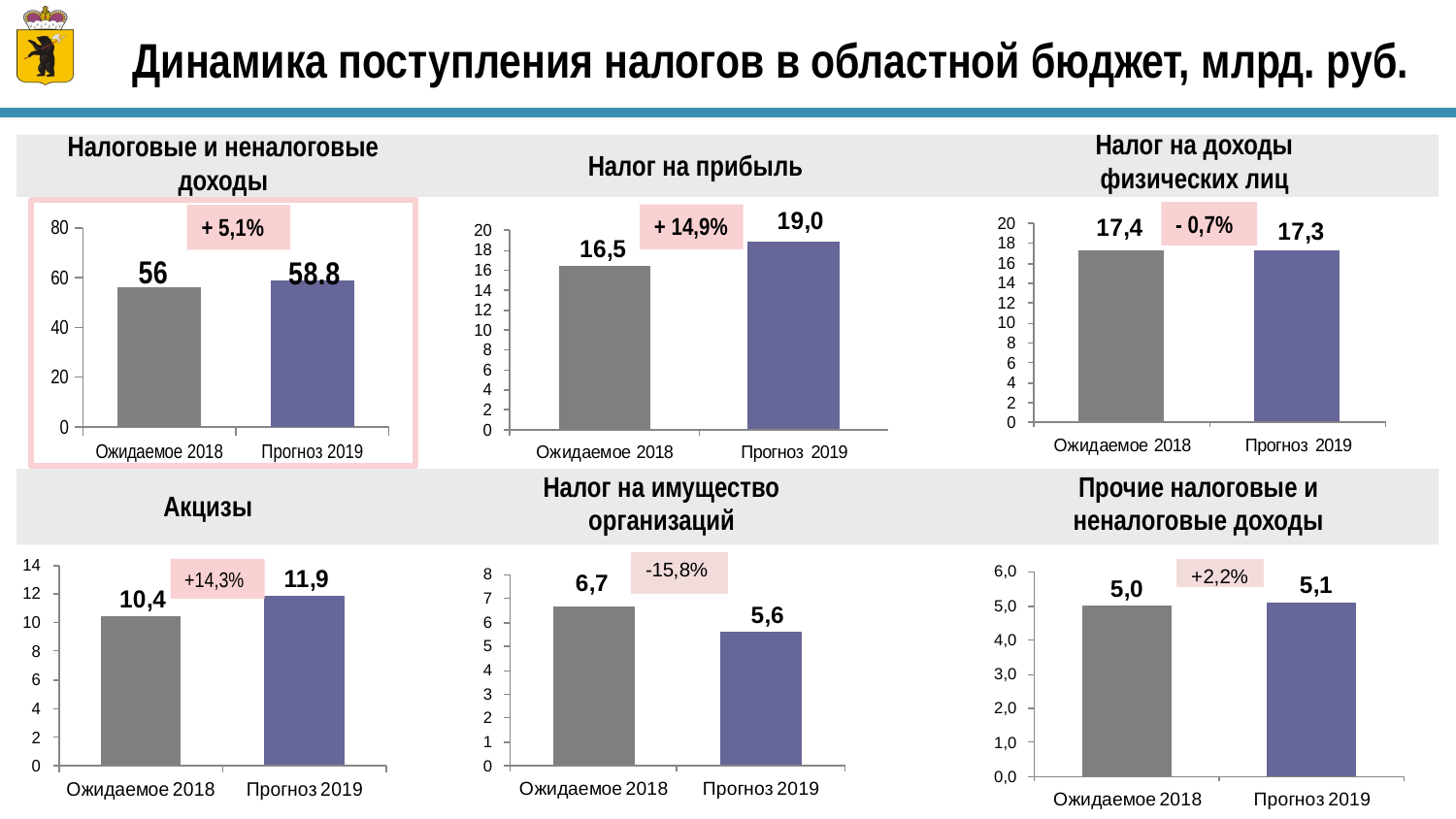
In the chart titled "Прочие налоговые и неналоговые доходы", which category has the lowest value? Ожидаемое 2018 How many categories are shown in the chart titled "Налог на прибыль"? 2 In the chart titled "Налог на имущество организаций", what percentage change is shown in the label between the bars? -15,8% In the chart titled "Налог на имущество организаций", what is the value for Ожидаемое 2018? 6,7 In the chart titled "Налог на прибыль", what is the value for Прогноз 2019? 19,0 In the chart titled "Акцизы", which category has the highest value? Прогноз 2019 In the chart titled "Налог на имущество организаций", which is larger, Ожидаемое 2018 or Прогноз 2019? Ожидаемое 2018 What kind of chart is the chart titled "Акцизы"? Bar chart In the chart titled "Налоговые и неналоговые доходы", what is the value for Ожидаемое 2018? 56 In the chart titled "Налог на доходы физических лиц", what is the value for Прогноз 2019? 17,3 In the chart titled "Акцизы", what is the value for Прогноз 2019? 11,9 In the chart titled "Налог на прибыль", what is the difference between Прогноз 2019 and Ожидаемое 2018? 2,5